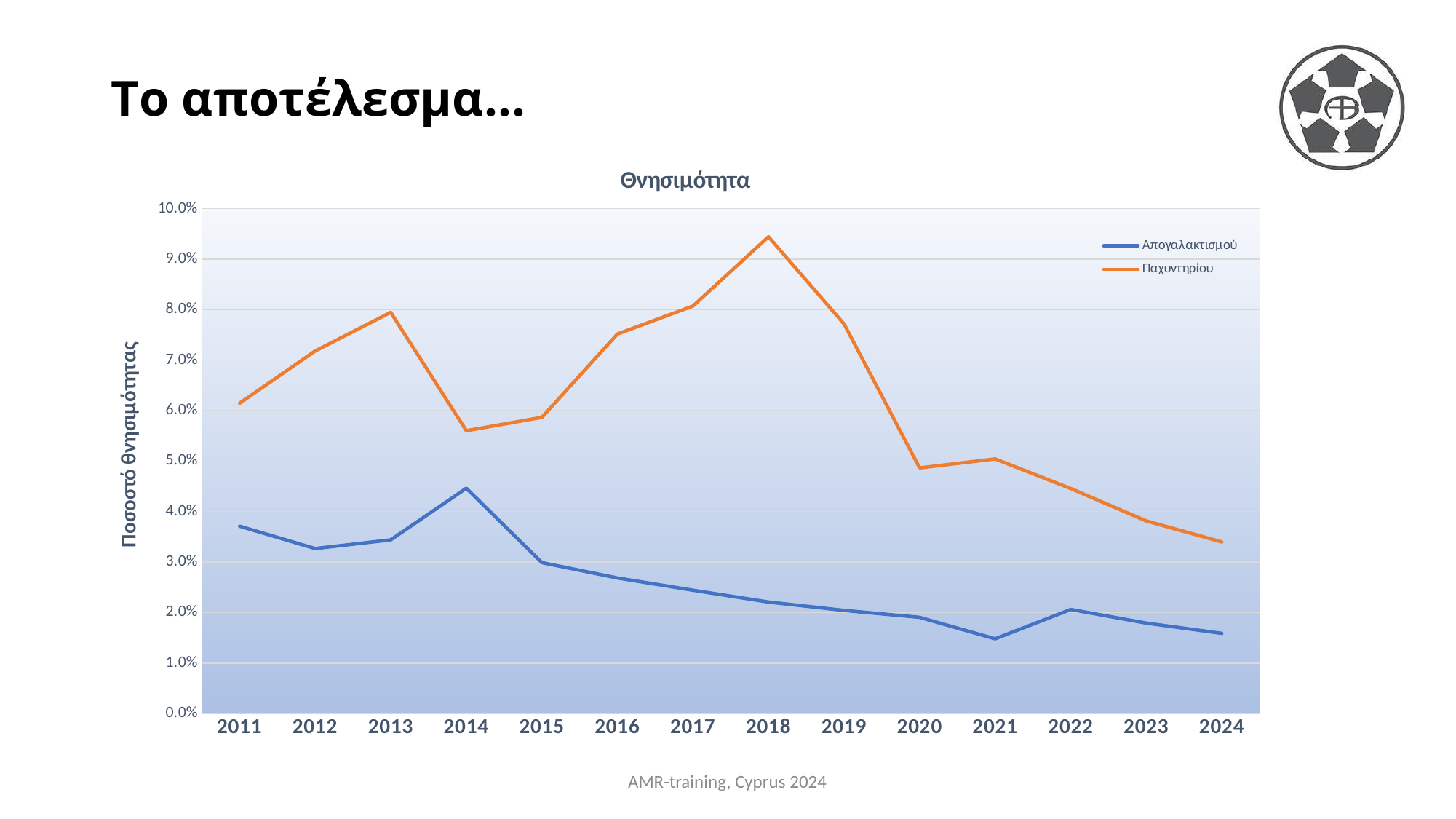
Is the value for Απογαλακτισμού in 2014 greater or less than 4.0%? greater Which series has the higher value in 2013, Απογαλακτισμού or Παχυντηρίου? Παχυντηρίου Does the Παχυντηρίου series rise or fall from 2018 to 2024? Fall How many years are plotted along the x axis? 14 Is the value for Παχυντηρίου in 2014 greater or less than 6.0%? less In which year does the Παχυντηρίου series reach its highest value? 2018 In which year does the Παχυντηρίου series reach its lowest value? 2024 What kind of chart is shown on the slide? Line chart In which year does the Απογαλακτισμού series reach its highest value? 2014 How many series does the legend list? 2 Is the value for Παχυντηρίου in 2018 greater or less than 9.0%? greater What is the title of the chart? Θνησιμότητα